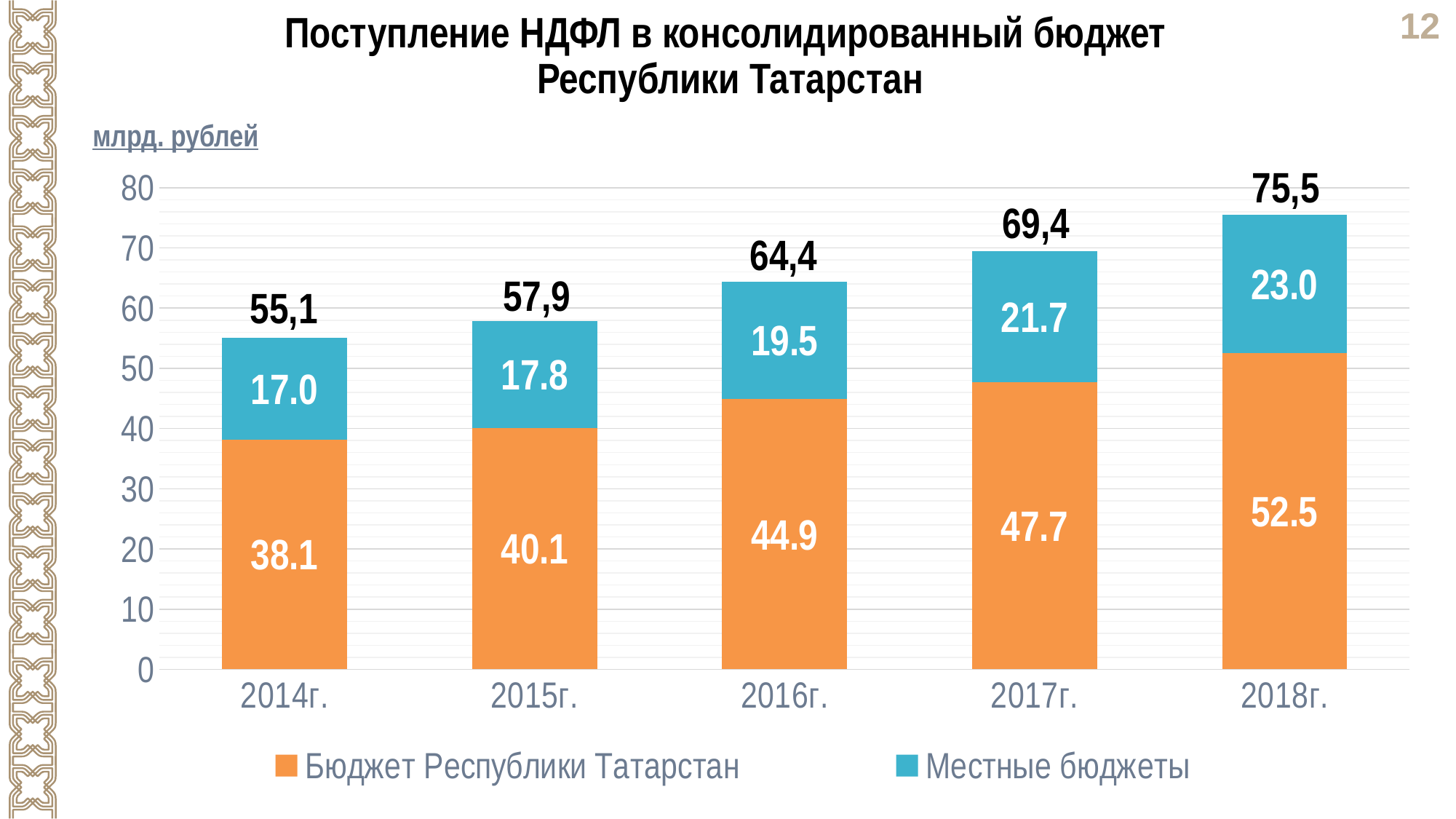
What is the difference between the Бюджет Республики Татарстан values for 2018г. and 2014г.? 14.4 Which is larger: Местные бюджеты in 2015г. or in 2016г.? 2016г. What is the value for Местные бюджеты in 2018г.? 23.0 Which year has the lowest value for Местные бюджеты? 2014г. What is the total of the stacked bar for 2017г.? 69,4 Is the total for 2016г. greater or less than 60? greater How many series does the legend list? 2 How many years are shown on the x axis? 5 What kind of chart is shown? stacked bar chart What is the value for Бюджет Республики Татарстан in 2016г.? 44.9 Which year has the highest total? 2018г. Do the totals rise or fall from 2014г. to 2018г.? rise